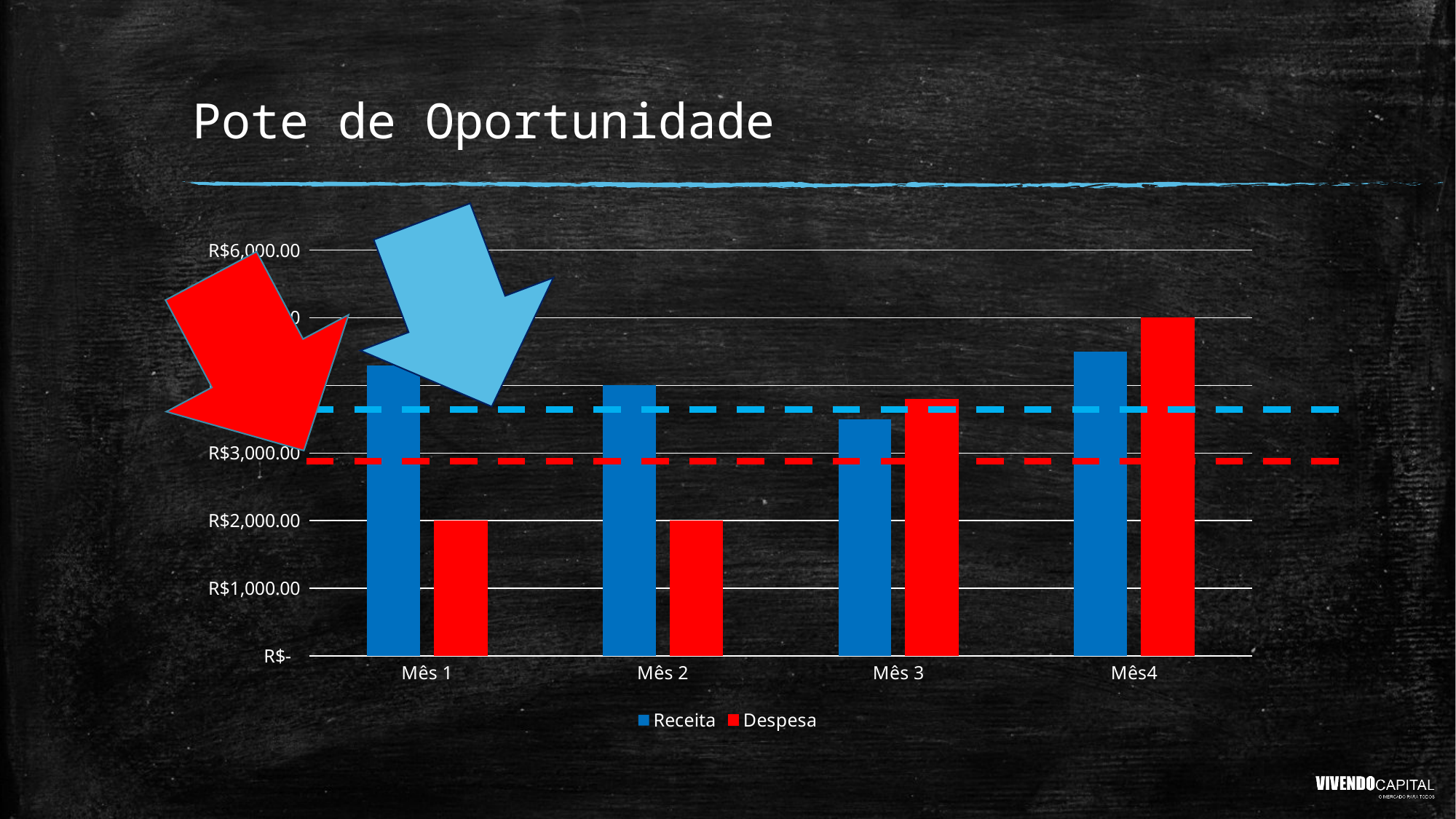
How many categories (months) are shown on the x axis? 4 In which month is Receita lowest? Mês 3 How many series does the legend list? 2 In Mês4, which is larger, Receita or Despesa? Despesa In which month is Despesa highest? Mês4 What is the title of the chart? Pote de Oportunidade Is the Receita value for Mês 1 greater or less than R$3,000.00? greater Is the Despesa value for Mês4 greater or less than R$3,000.00? greater What type of chart is shown on the slide? bar chart In Mês 1, which is larger, Receita or Despesa? Receita What is the Despesa value for Mês 1? R$2,000.00 What is the Despesa value for Mês 2? R$2,000.00